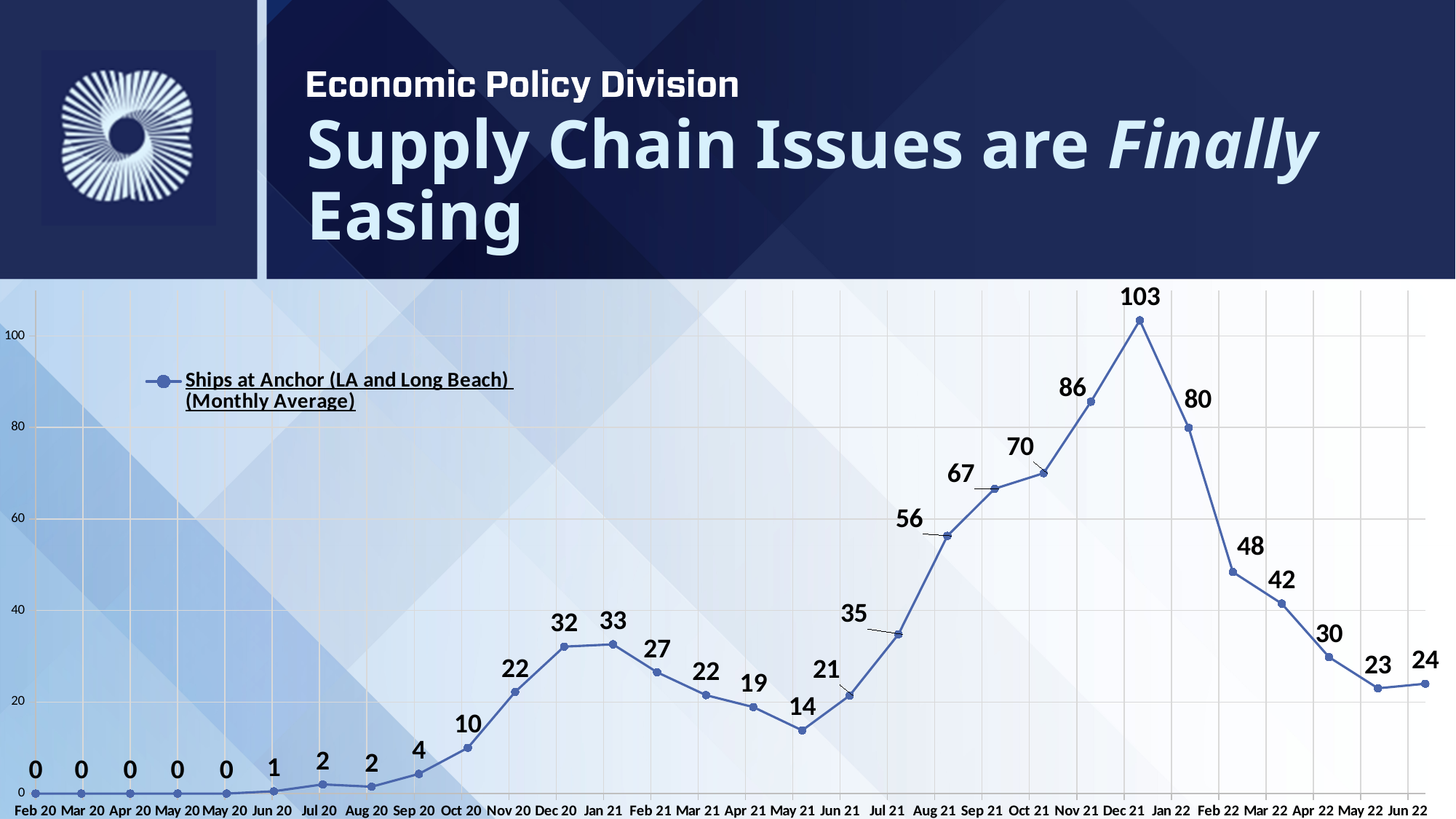
Is the value for Aug 21 greater or less than 40? greater Which is larger, the value for Nov 21 or the value for Jan 22? Nov 21 What is the value for Jan 22? 80 What is the value for Jun 22? 24 What is the value for Dec 21? 103 What kind of chart is shown on the slide? line chart What series name is shown in the legend? Ships at Anchor (LA and Long Beach) (Monthly Average) Do the values rise or fall from Dec 21 to May 22? fall Which month has the highest value? Dec 21 What is the value for Jan 21? 33 What is the difference between the values for Dec 21 and Jan 22? 23 How many series does the legend list? 1